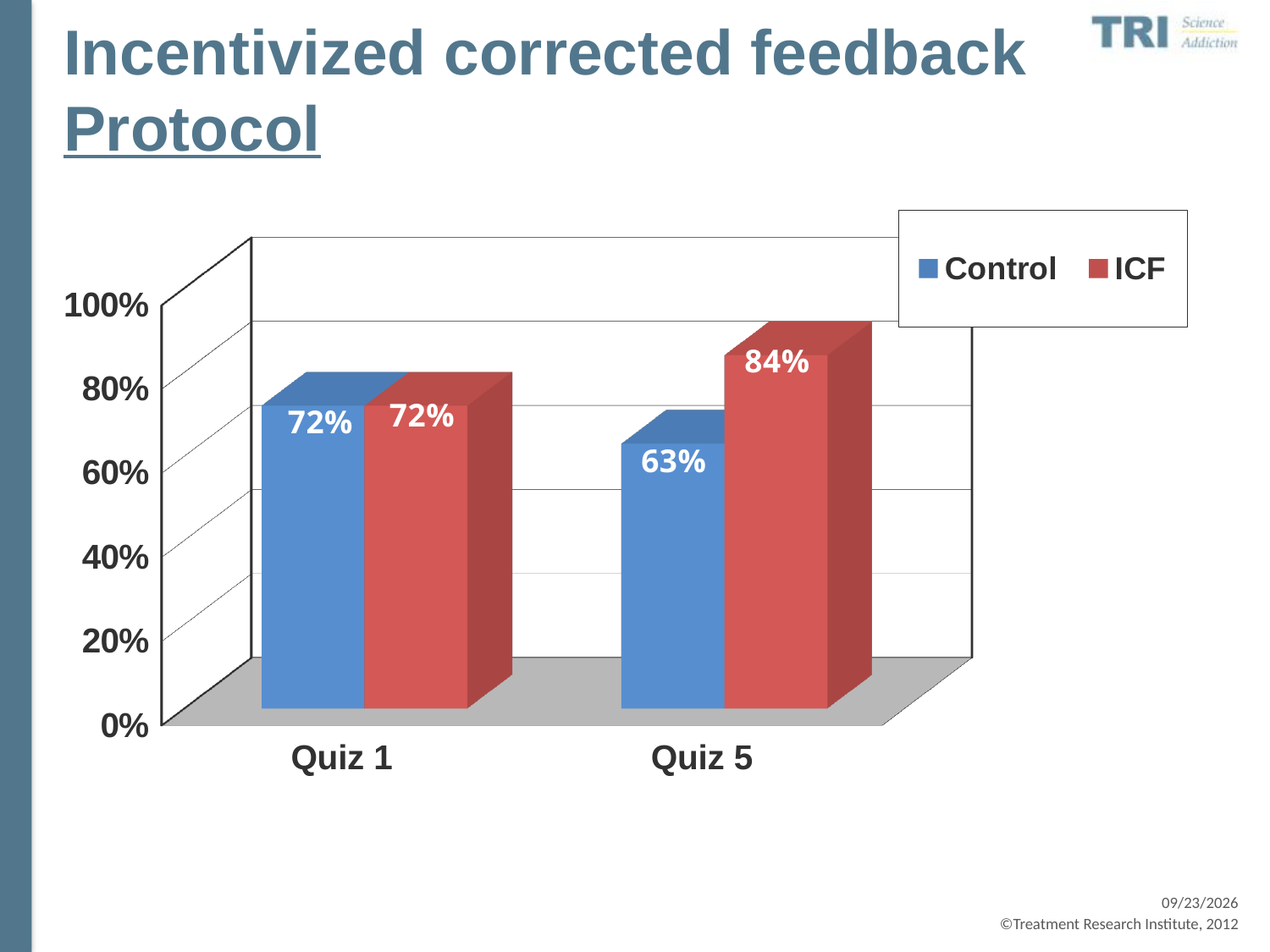
Which quiz has the lowest Control value? Quiz 5 For Quiz 5, which is larger, the Control value or the ICF value? ICF How many series does the legend list? 2 What is the difference between the ICF and Control values for Quiz 5? 21% Which quiz has the highest ICF value? Quiz 5 What is the ICF value for Quiz 5? 84% How many quiz categories are shown on the x axis? 2 What is the Control value for Quiz 5? 63% What is the ICF value for Quiz 1? 72% What is the Control value for Quiz 1? 72% What is the difference between the Control values for Quiz 1 and Quiz 5? 9% What kind of chart is shown on the slide? Bar chart